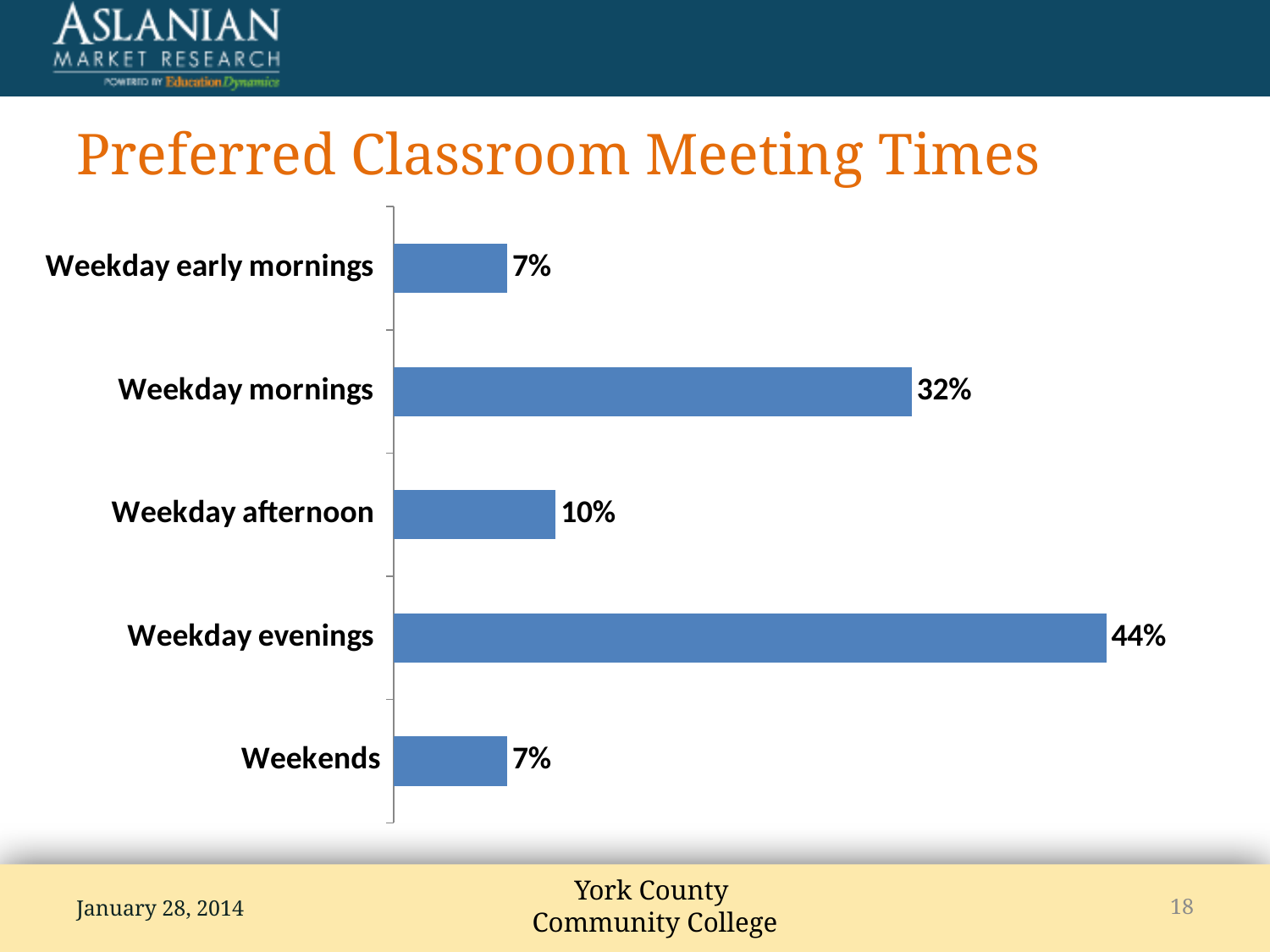
What kind of chart is shown on the slide? Bar chart What is the difference between the values for Weekday evenings and Weekday mornings? 12% Which is larger, the value for Weekday mornings or the value for Weekday afternoon? Weekday mornings What is the title of the slide containing the chart? Preferred Classroom Meeting Times Which category has the lowest value, Weekday mornings or Weekday afternoon? Weekday afternoon What is the value for Weekday early mornings? 7% What is the difference between the values for Weekday afternoon and Weekends? 3% What is the value for Weekday mornings? 32% How many categories are shown in the chart? 5 What is the value for Weekday evenings? 44% What is the value for Weekday afternoon? 10% Which category has the highest value? Weekday evenings